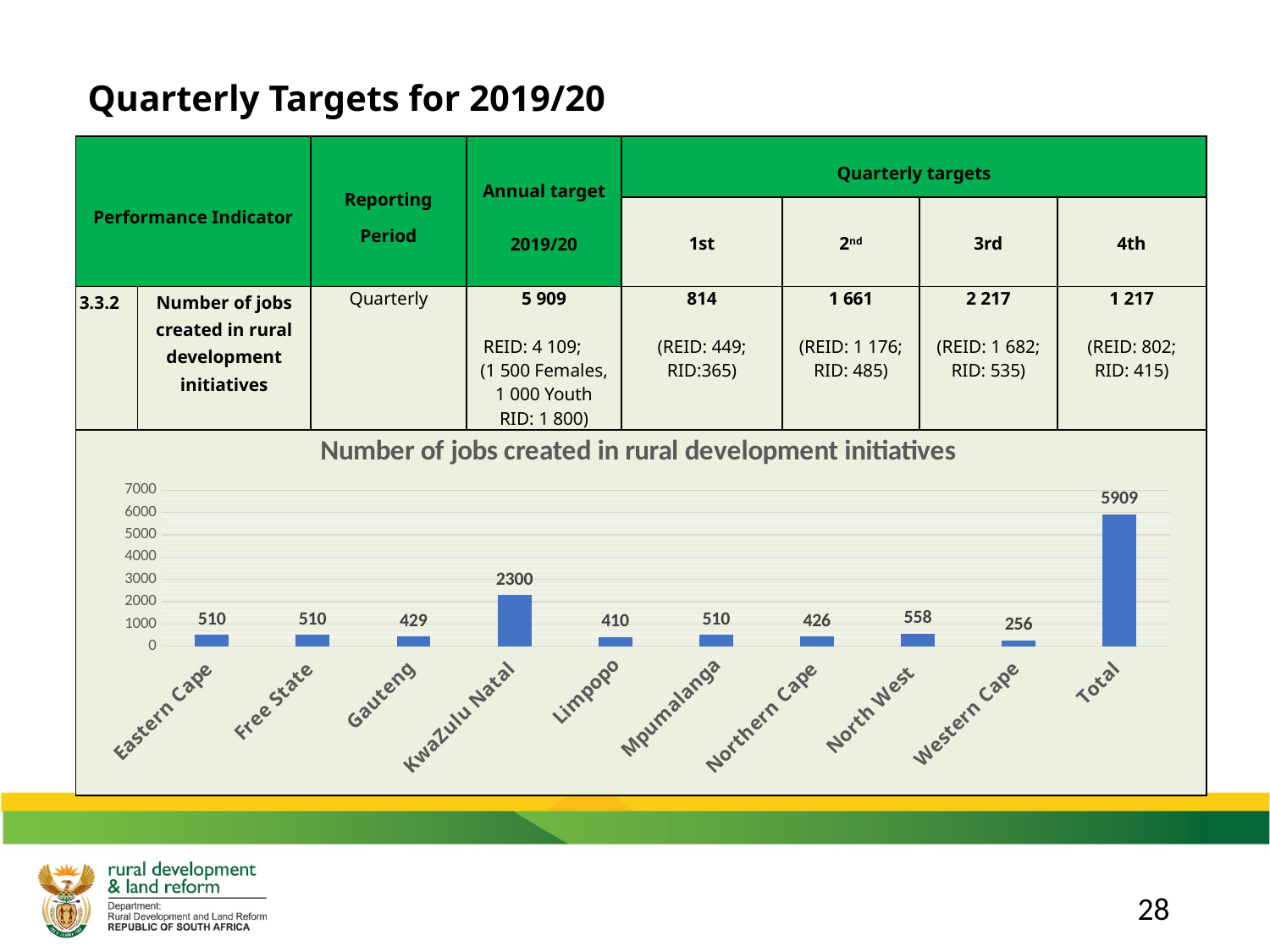
Which is larger, the value for North West or the value for Northern Cape? North West What is the value for North West in the chart? 558 How many bars are shown in the chart? 10 What is the difference between the values for KwaZulu Natal and Limpopo? 1890 What is the value for Western Cape in the chart? 256 What kind of chart is shown on the slide? Bar chart What is the value for Gauteng in the chart? 429 Excluding the Total bar, which province has the highest value in the chart? KwaZulu Natal Is the value for the Total bar greater or less than 5000? greater What is the title of the chart? Number of jobs created in rural development initiatives What is the value for KwaZulu Natal in the chart? 2300 Which province has the lowest value in the chart? Western Cape